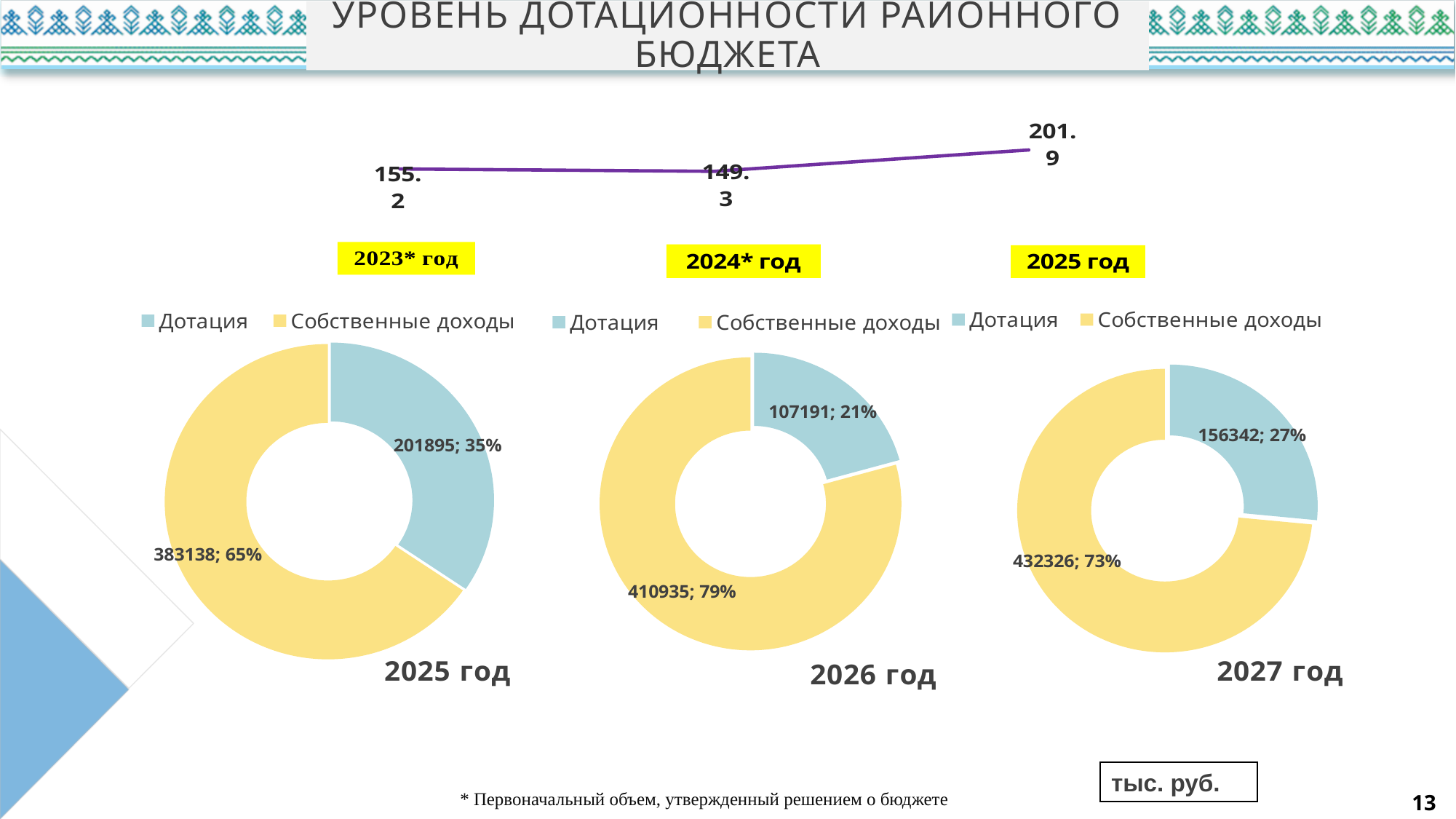
In the right donut chart titled "2027 год", which segment is larger, Дотация or Собственные доходы? Собственные доходы In the left donut chart titled "2025 год", what share of the total is Собственные доходы? 65% How many series does the legend of the middle donut chart titled "2026 год" list? 2 In the middle donut chart titled "2026 год", what is the value for Собственные доходы? 410935; 79% What kind of chart is used for the three charts in the lower part of the slide? Donut (pie) chart In the left donut chart titled "2025 год", what is the value for Дотация? 201895; 35% In the right donut chart titled "2027 год", what is the difference between Собственные доходы and Дотация? 275984 In the line chart at the top of the slide, which point has the highest value? 2025 год (201.9) In the right donut chart titled "2027 год", what is the value for Дотация? 156342; 27% How many data points does the line chart at the top of the slide have? 3 In the middle donut chart titled "2026 год", what share of the total is Дотация? 21% In the line chart at the top of the slide, what is the value for the point labelled 2024* год? 149.3